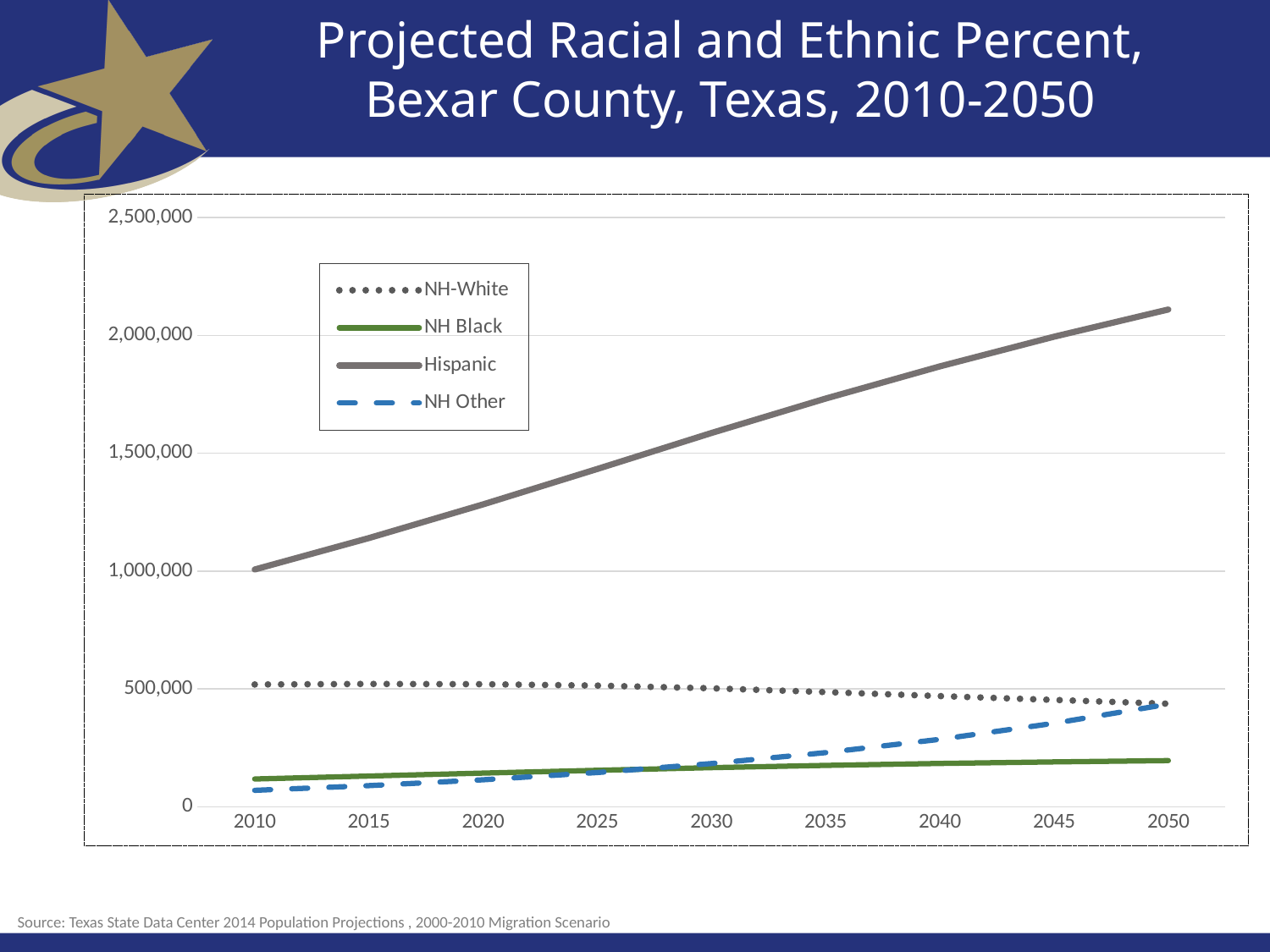
Does the Hispanic series rise or fall from 2010 to 2050? Rise Is the value for Hispanic in 2020 greater or less than 1,500,000? less Is the value for Hispanic in 2050 greater or less than 2,000,000? greater What kind of chart is shown on the slide? Line chart Is the value for NH Black in 2050 greater or less than 500,000? less Which series has the highest value in 2050? Hispanic In 2050, which is larger: NH Other or NH Black? NH Other Which series is drawn with a dotted line in the legend? NH-White Which series has the lowest value in 2010? NH Other How many series does the legend list? 4 Does the NH-White series rise or fall from 2010 to 2050? Fall How many year labels are shown along the x axis? 9